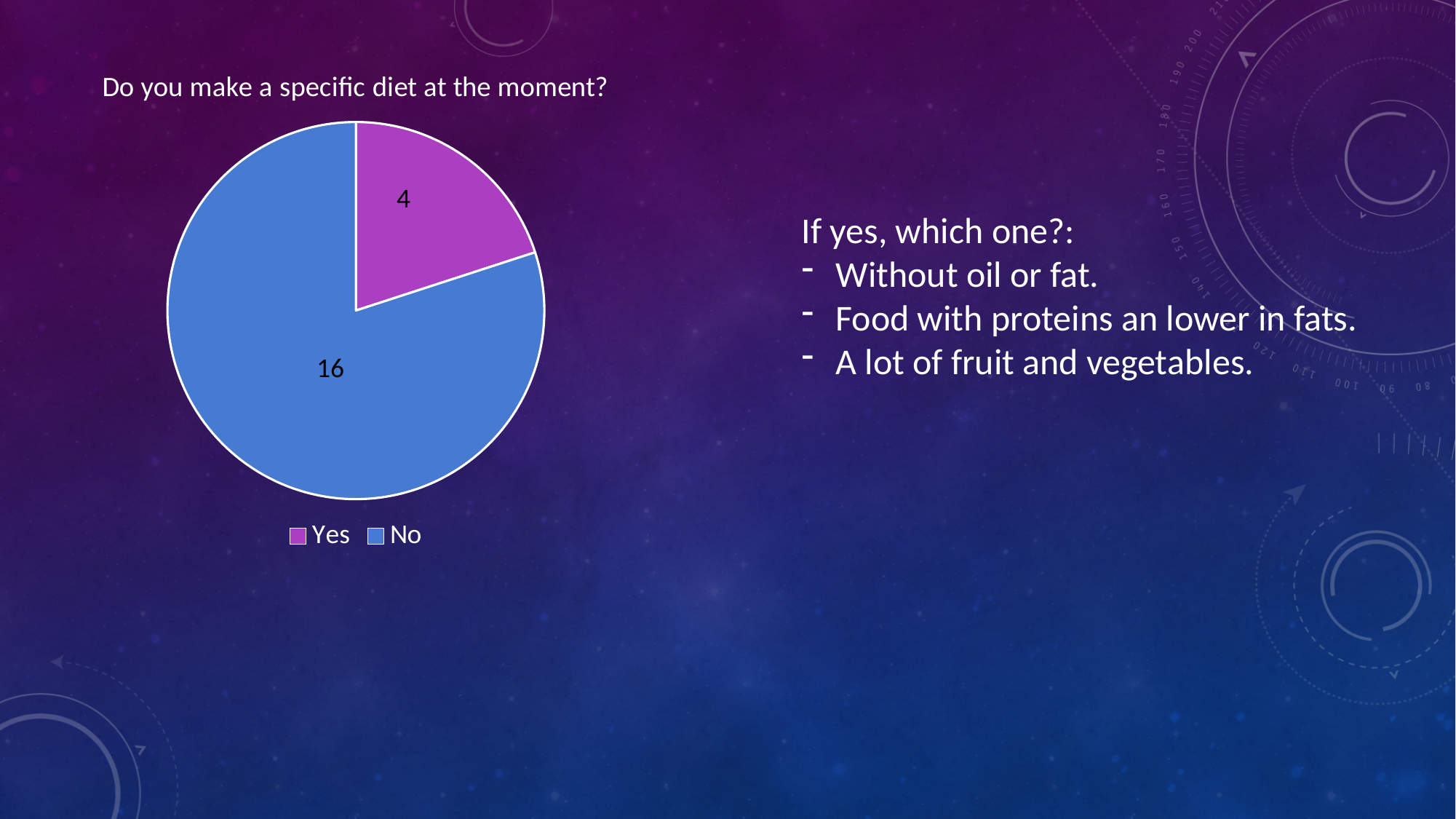
What share of the pie chart does the "Yes" slice represent? 20% What is the value for "No" in the pie chart? 16 Which category has the largest slice in the pie chart? No What is the value for "Yes" in the pie chart? 4 What share of the pie chart does the "No" slice represent? 80% How many categories does the pie chart show? 2 What is the difference between the "No" and "Yes" values in the pie chart? 12 Which category has the smallest slice in the pie chart? Yes What is the title of the pie chart? Do you make a specific diet at the moment? How many entries does the legend of the pie chart list? 2 Which is larger in the pie chart, "Yes" or "No"? No What kind of chart is shown on the slide? pie chart